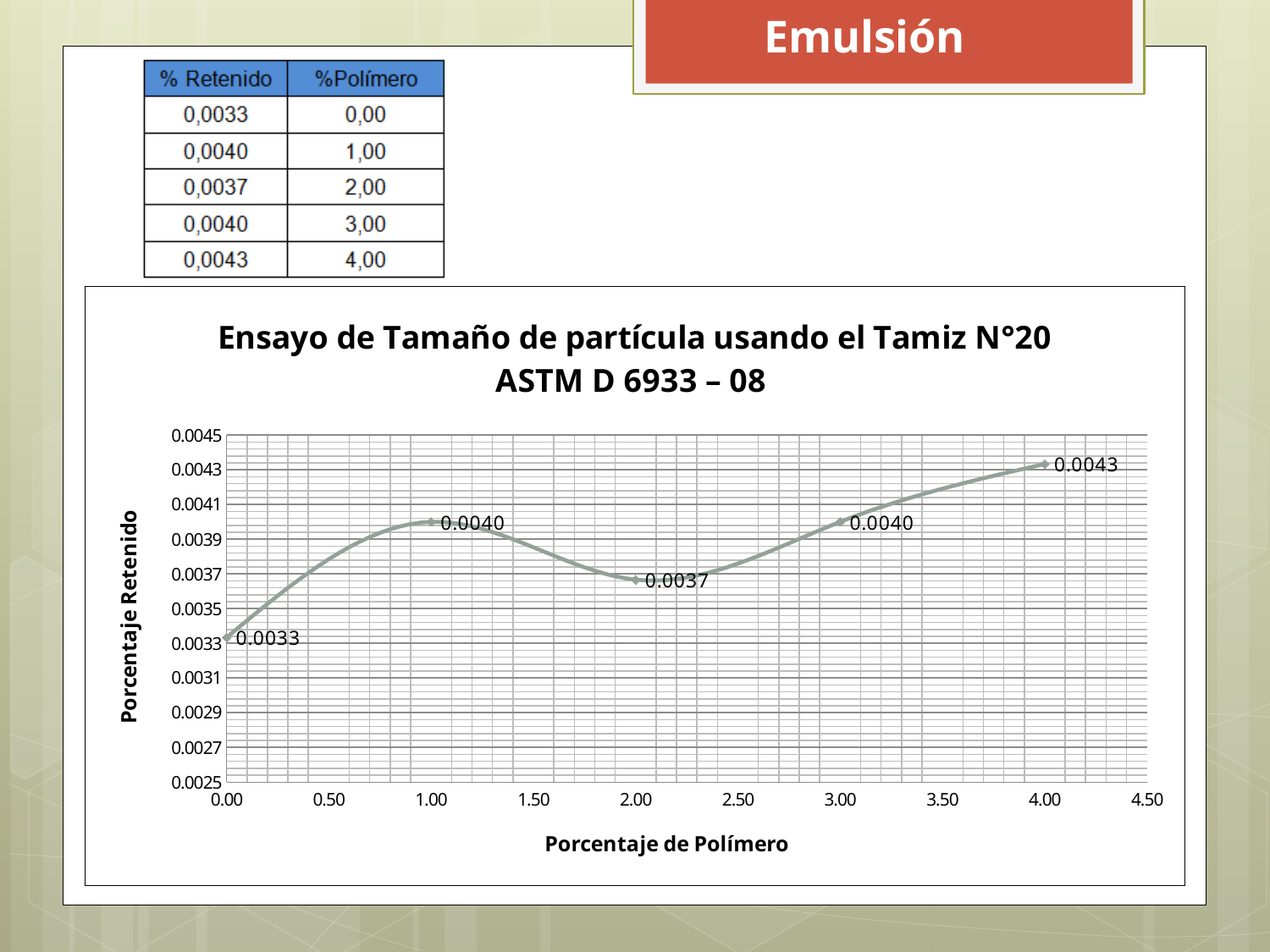
Which has a larger Porcentaje Retenido: Porcentaje de Polímero 1.00 or 2.00? 1.00 What is the Porcentaje Retenido value at Porcentaje de Polímero 2.00? 0.0037 How many data points are plotted on the chart? 5 Is the Porcentaje Retenido at Porcentaje de Polímero 4.00 greater or less than 0.0041? greater At which Porcentaje de Polímero value is the Porcentaje Retenido lowest? 0.00 What kind of chart is shown on the slide? line chart What is the difference between the Porcentaje Retenido at 4.00 and at 0.00 Porcentaje de Polímero? 0.0010 What is the Porcentaje Retenido value at Porcentaje de Polímero 0.00? 0.0033 What is the Porcentaje Retenido value at Porcentaje de Polímero 4.00? 0.0043 What is the label of the x axis of the chart? Porcentaje de Polímero What is the title of the chart? Ensayo de Tamaño de partícula usando el Tamiz N°20 ASTM D 6933 – 08 At which Porcentaje de Polímero value is the Porcentaje Retenido highest? 4.00